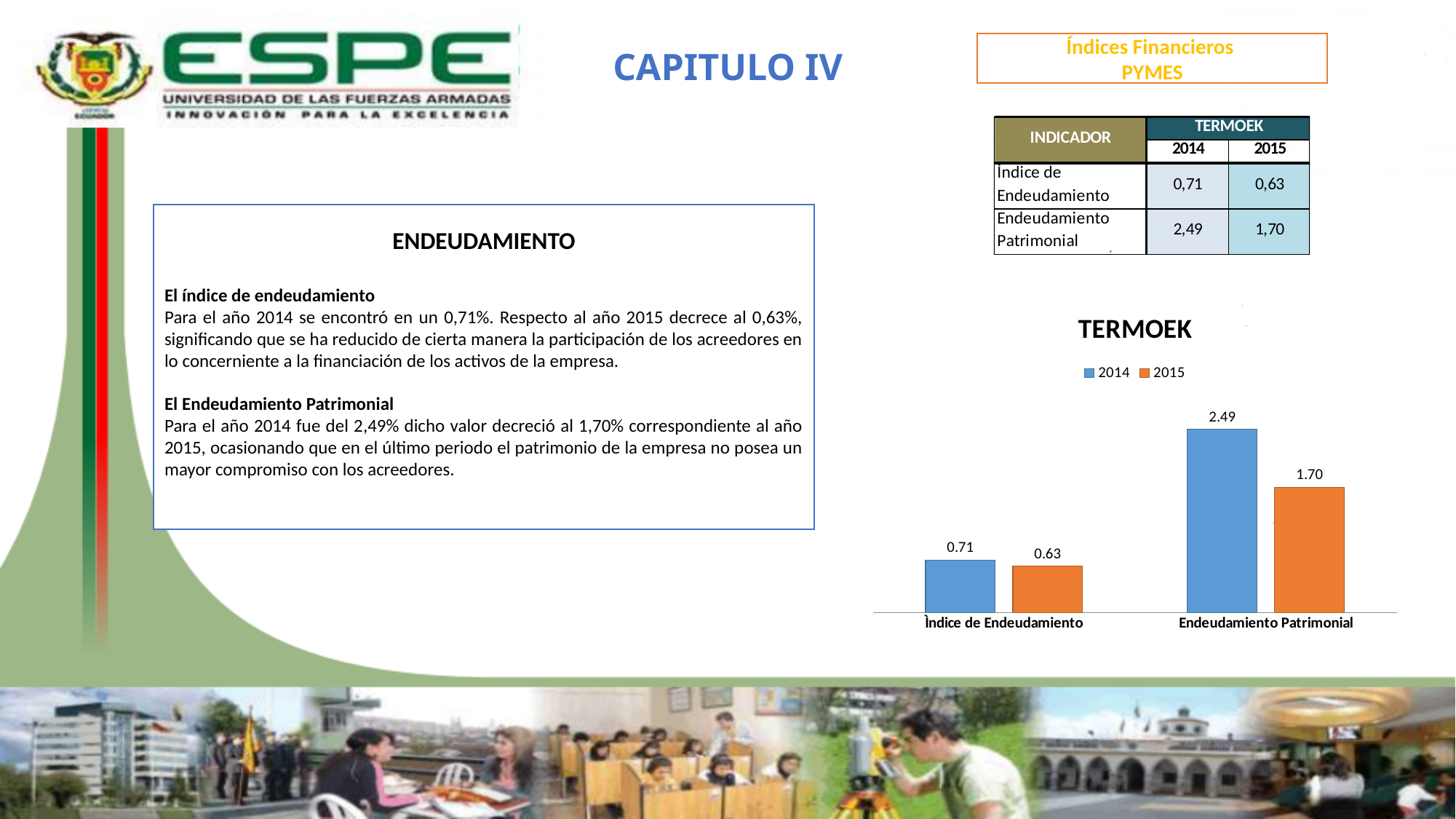
What is the value for 2015 for Endeudamiento Patrimonial in the TERMOEK chart? 1.70 Which bar is the lowest in the TERMOEK chart? Índice de Endeudamiento, 2015 What kind of chart is the TERMOEK chart? Bar chart What is the difference between the 2014 and 2015 values for Endeudamiento Patrimonial in the TERMOEK chart? 0.79 What is the value for 2014 for Índice de Endeudamiento in the TERMOEK chart? 0.71 What is the value for 2015 for Índice de Endeudamiento in the TERMOEK chart? 0.63 How many series does the legend of the TERMOEK chart list? 2 Which colour represents the 2015 series in the TERMOEK chart? Orange In the TERMOEK chart, which is larger for Endeudamiento Patrimonial: the 2014 value or the 2015 value? 2014 How many categories are shown on the x axis of the TERMOEK chart? 2 What is the difference between the 2014 and 2015 values for Índice de Endeudamiento in the TERMOEK chart? 0.08 Which bar is the highest in the TERMOEK chart? Endeudamiento Patrimonial, 2014